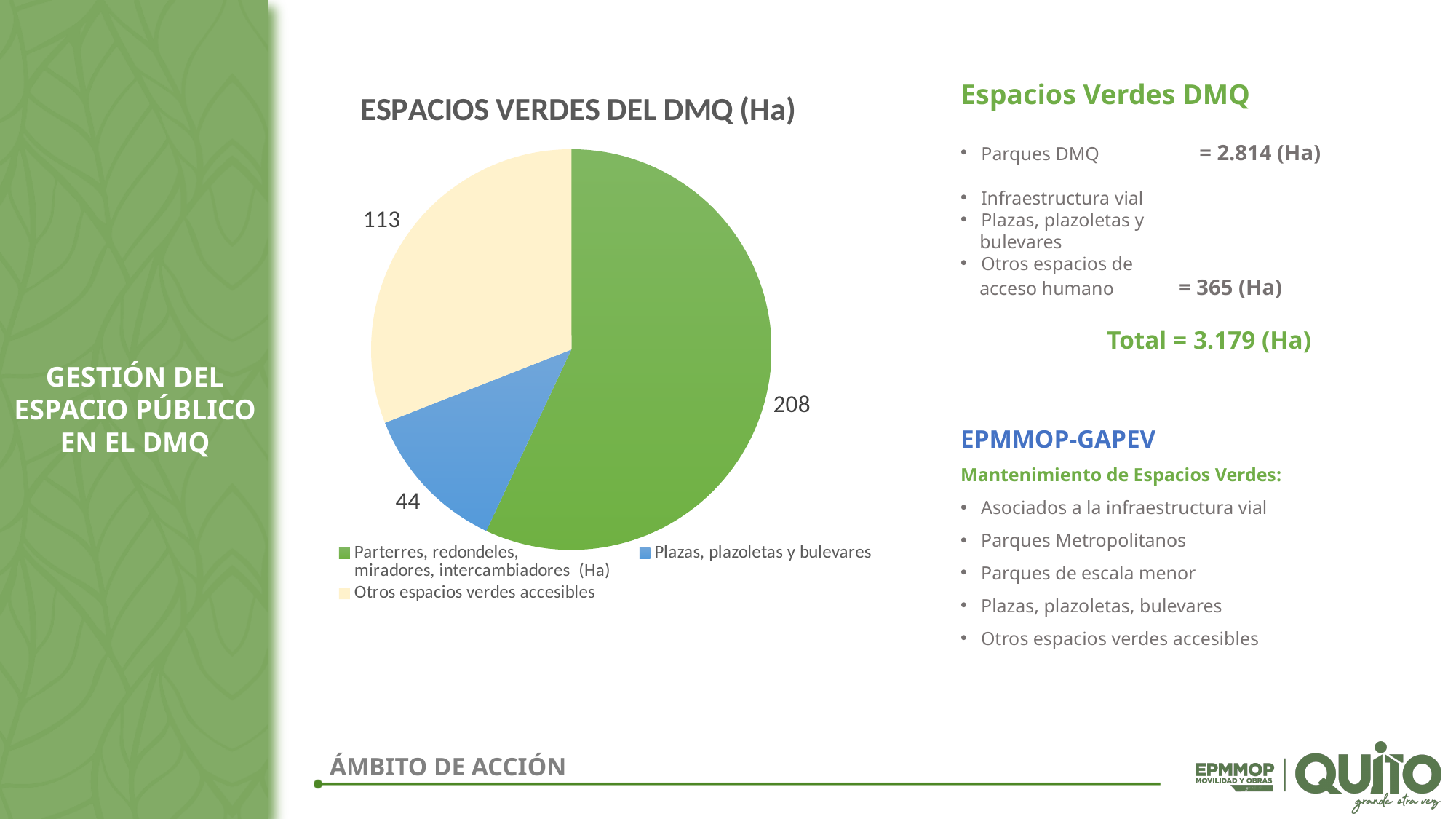
What is the difference between the values for Parterres, redondeles, miradores, intercambiadores and Otros espacios verdes accesibles? 95 What is the value for Otros espacios verdes accesibles? 113 What is the value for Parterres, redondeles, miradores, intercambiadores (Ha)? 208 What type of chart is shown on the slide? pie chart Which is larger: Otros espacios verdes accesibles or Plazas, plazoletas y bulevares? Otros espacios verdes accesibles Which category has the smallest slice of the pie? Plazas, plazoletas y bulevares What colour is the slice for Plazas, plazoletas y bulevares? blue What is the total of all the slices in the pie chart? 365 Which category has the largest slice of the pie? Parterres, redondeles, miradores, intercambiadores (Ha) What is the title of the chart? ESPACIOS VERDES DEL DMQ (Ha) What is the value for Plazas, plazoletas y bulevares? 44 How many slices does the pie chart have? 3